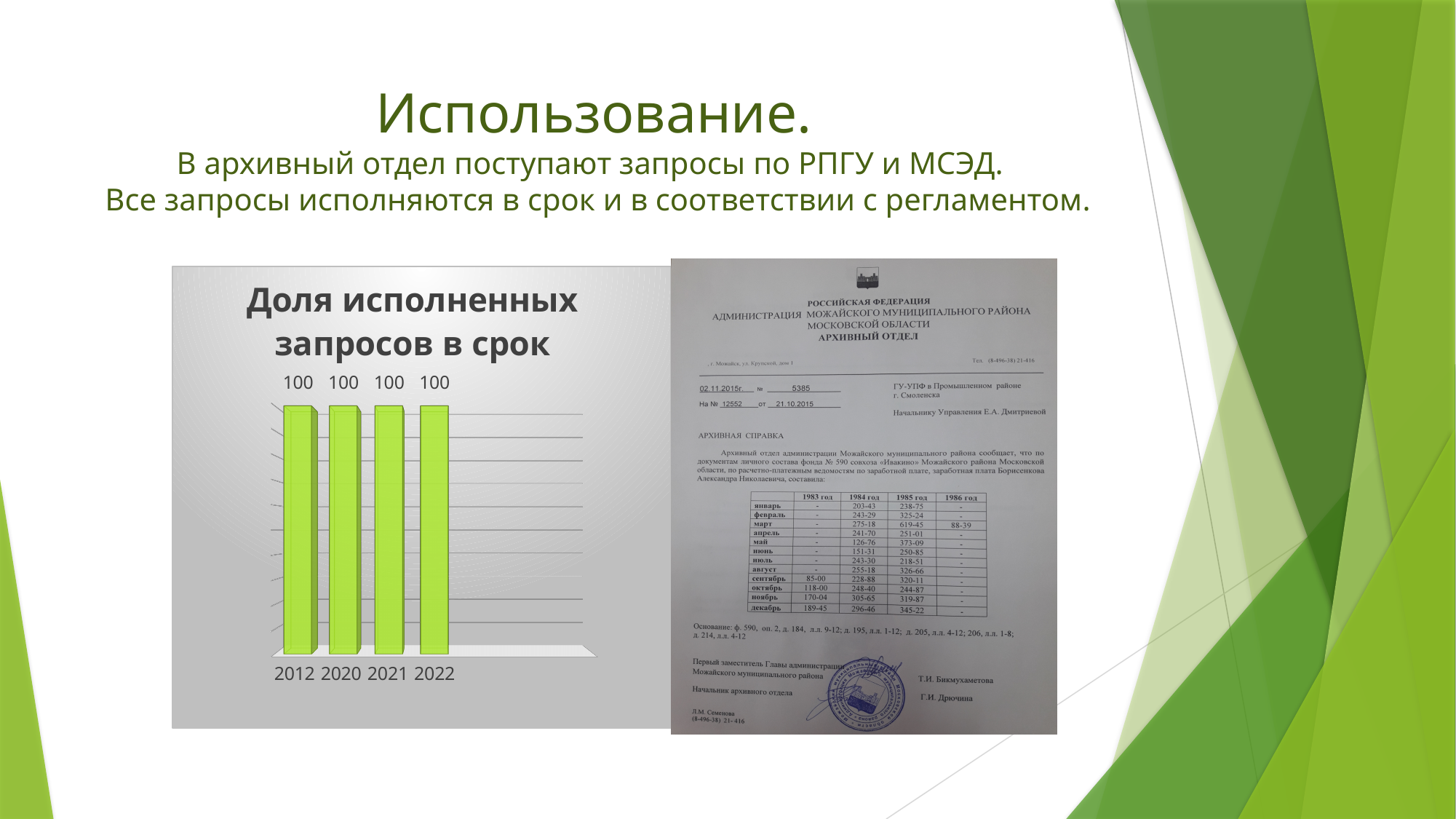
What is the total of the values for 2020 and 2021 in the chart? 200 What kind of chart is shown on the slide? bar chart What is the value for 2012 in the chart? 100 What is the value for 2021 in the chart? 100 What is the difference between the values for 2022 and 2012 in the chart? 0 What is the title of the chart on the slide? Доля исполненных запросов в срок What is the value for 2022 in the chart? 100 Do the values in the chart rise, fall, or stay the same from 2012 to 2022? stay the same What is the value for 2020 in the chart? 100 What is the first year shown on the x axis of the chart? 2012 How many categories (years) are shown on the x axis of the chart? 4